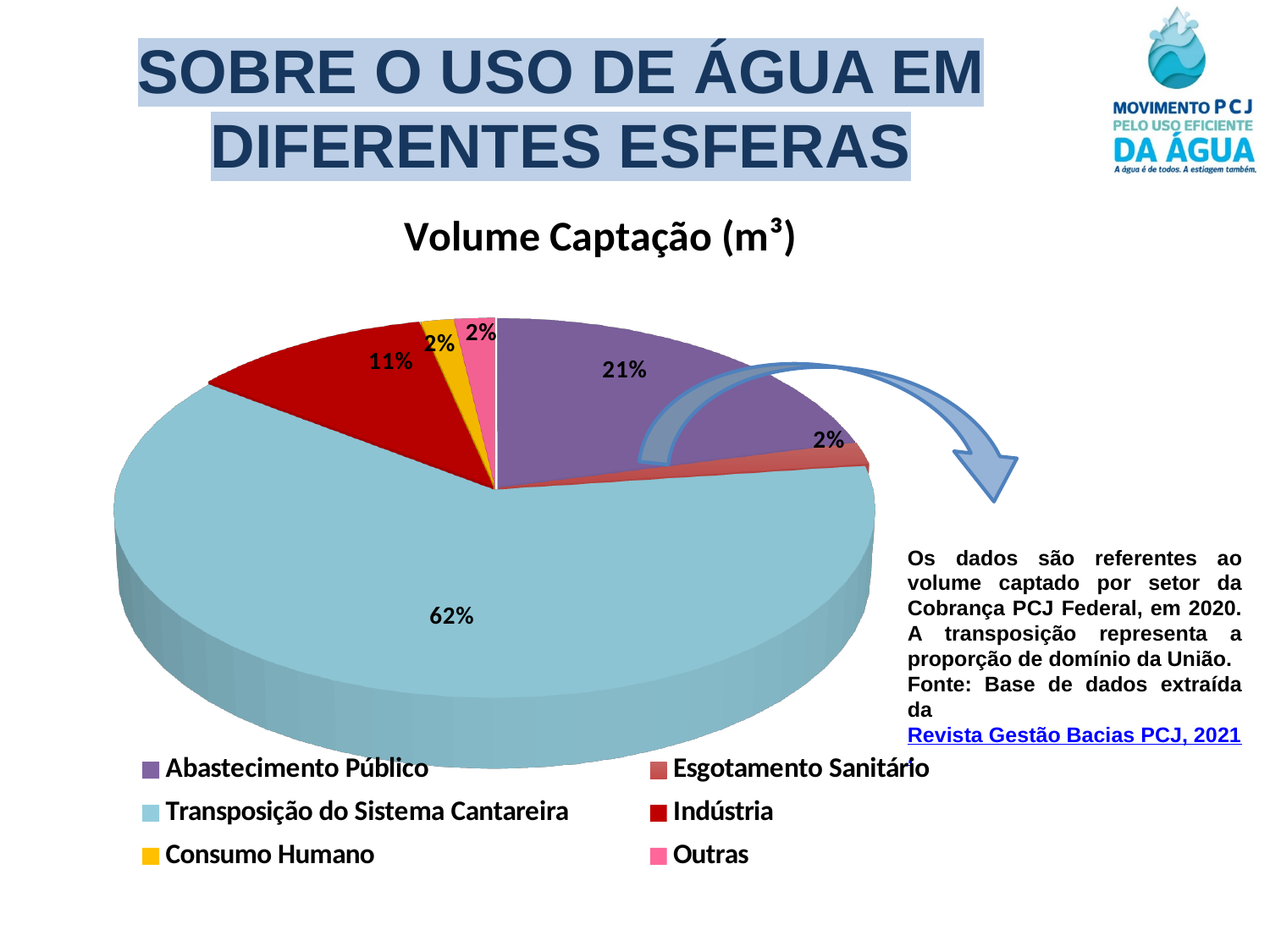
What colour is the slice for Indústria? Dark red What is the title of the chart? Volume Captação (m³) Which is larger, the share for Abastecimento Público or the share for Indústria? Abastecimento Público What is the difference in percentage points between Transposição do Sistema Cantareira and Abastecimento Público? 41 What type of chart is shown on the slide? Pie chart What share of the pie does Consumo Humano represent? 2% What share of the pie does Esgotamento Sanitário represent? 2% How many categories does the legend list? 6 What share of the pie does Indústria represent? 11% Which category has the largest slice of the pie? Transposição do Sistema Cantareira